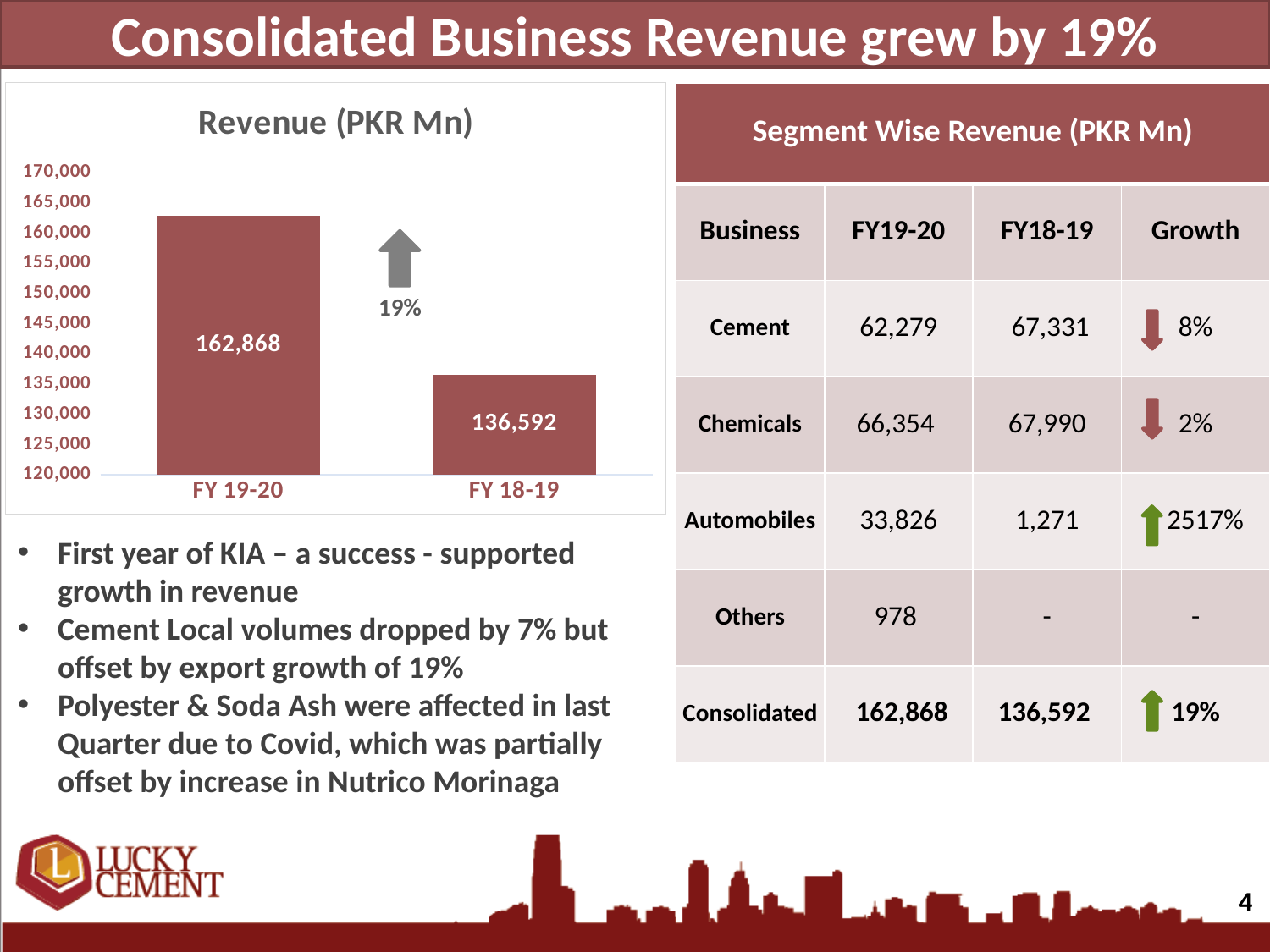
How many bars are plotted in the Revenue (PKR Mn) chart? 2 What is the difference between the FY 19-20 and FY 18-19 revenue values in the chart? 26,276 Is the value for FY 19-20 greater or less than 160,000? greater What growth percentage is annotated between the two bars in the Revenue (PKR Mn) chart? 19% What is the title of the chart on the left of the slide? Revenue (PKR Mn) What is the revenue value for FY 19-20 in the Revenue (PKR Mn) chart? 162,868 What type of chart is used to show Revenue (PKR Mn)? bar chart Which period has the higher revenue in the Revenue (PKR Mn) chart? FY 19-20 Which period has the lower revenue in the Revenue (PKR Mn) chart? FY 18-19 Is the revenue for FY 19-20 larger or smaller than the revenue for FY 18-19? larger What is the revenue value for FY 18-19 in the Revenue (PKR Mn) chart? 136,592 Is the value for FY 18-19 greater or less than 140,000? less